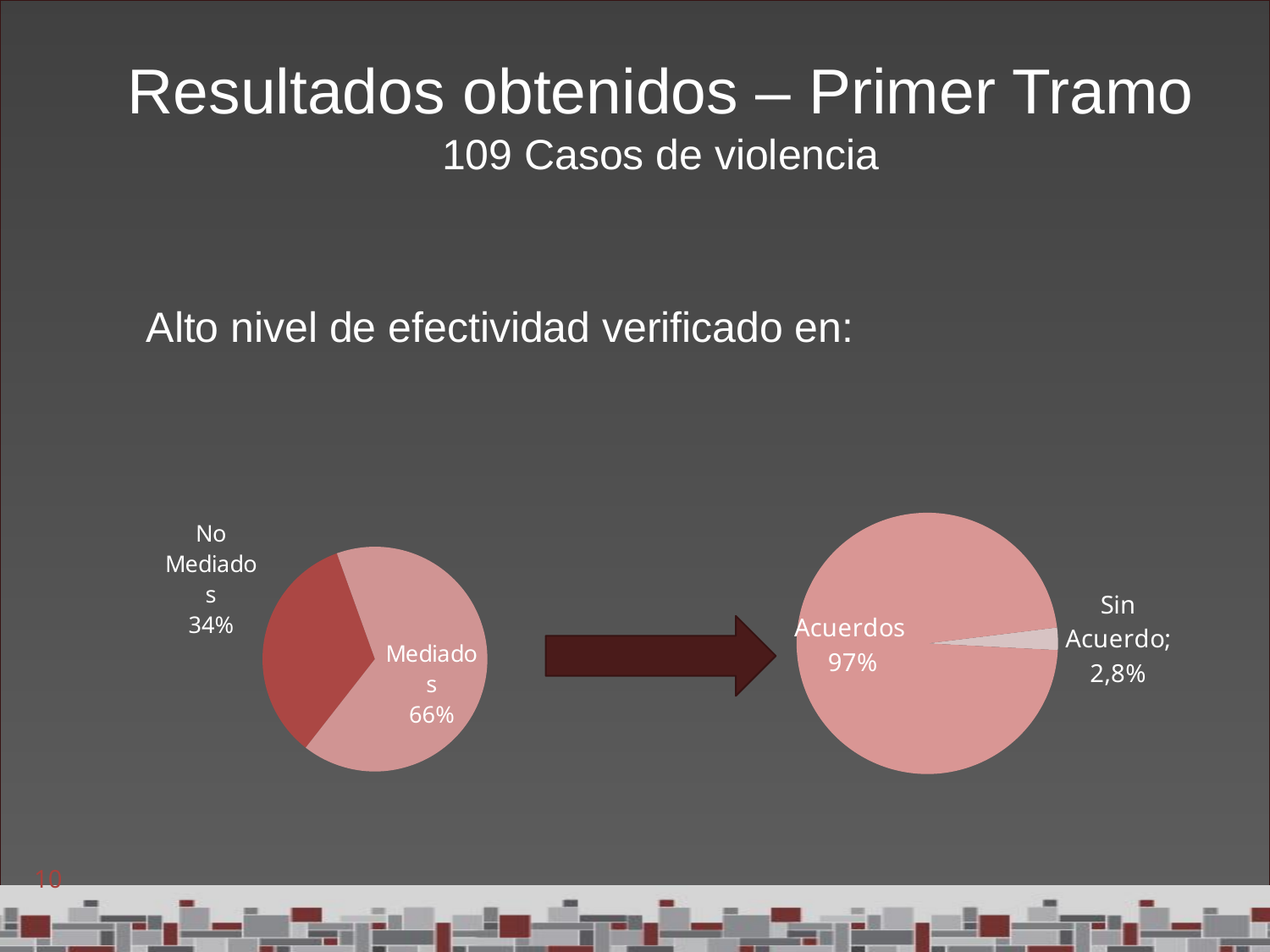
In the left pie chart, which is larger, Mediados or No Mediados? Mediados In the right pie chart, what share is labelled for Acuerdos? 97% In the left pie chart, what is the difference in percentage points between Mediados and No Mediados? 32 How many slices does the right pie chart have? 2 How many pie charts are shown on the slide? 2 What kind of chart is the right chart on the slide? Pie chart In the right pie chart, what share is labelled for Sin Acuerdo? 2,8% In the right pie chart, which slice is the smallest? Sin Acuerdo How many slices does the left pie chart have? 2 In the left pie chart, which slice is the largest? Mediados In the left pie chart, what share is labelled for No Mediados? 34% In the left pie chart, what share is labelled for Mediados? 66%